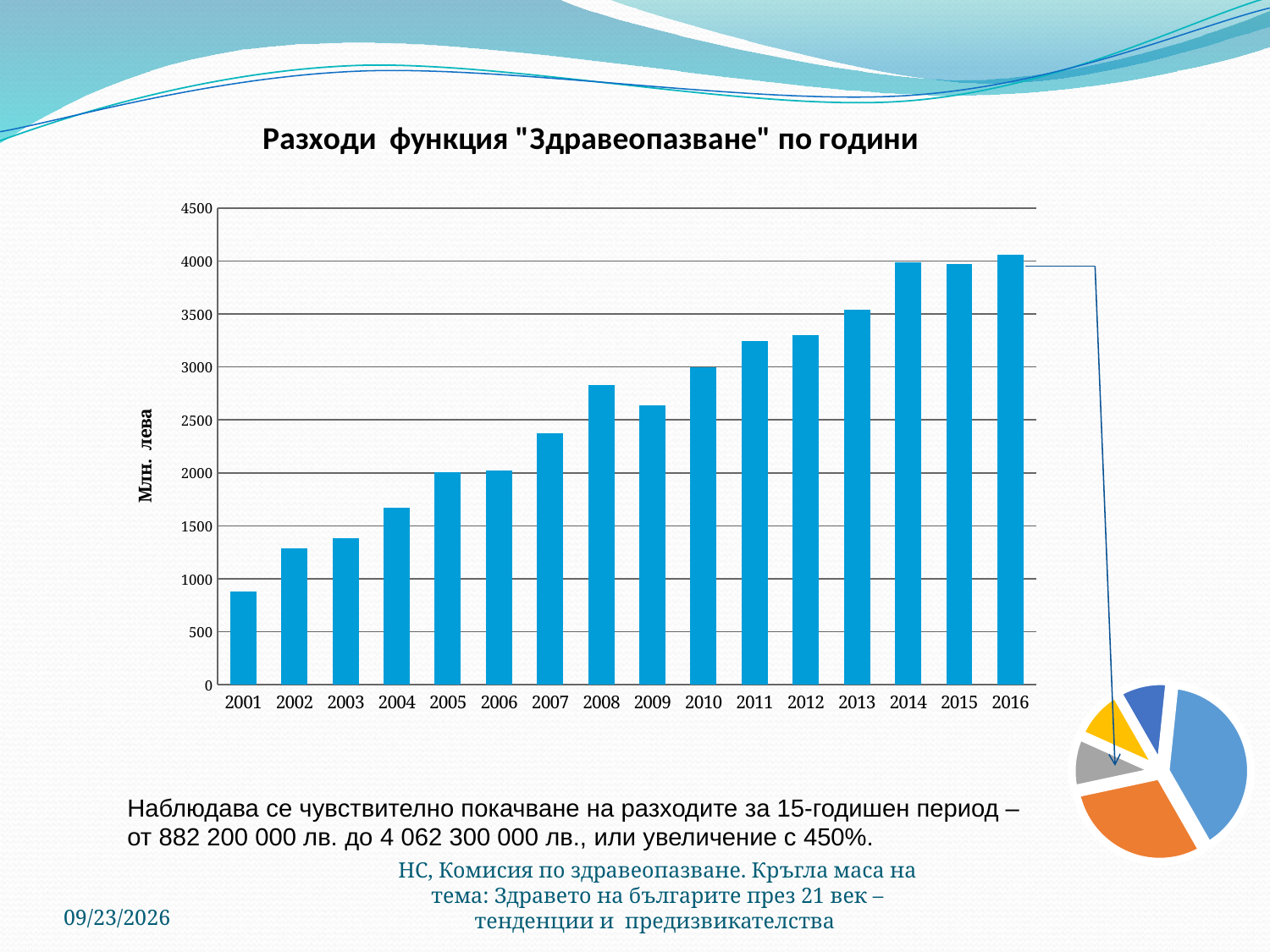
Which year has the larger value, 2008 or 2009? 2008 What kind of chart is shown on the slide? Bar chart Which year has the highest value in the chart? 2016 What is the label of the vertical axis? Млн. лева How many years are shown on the x axis of the chart? 16 Which year has the lowest value in the chart? 2001 Is the value for 2008 greater or less than 3000? less What is the title of the chart? Разходи функция "Здравеопазване" по години Do the values generally rise or fall from 2001 to 2016? Rise Is the value for 2016 greater or less than 4000? greater Is the value for 2001 greater or less than 1000? less